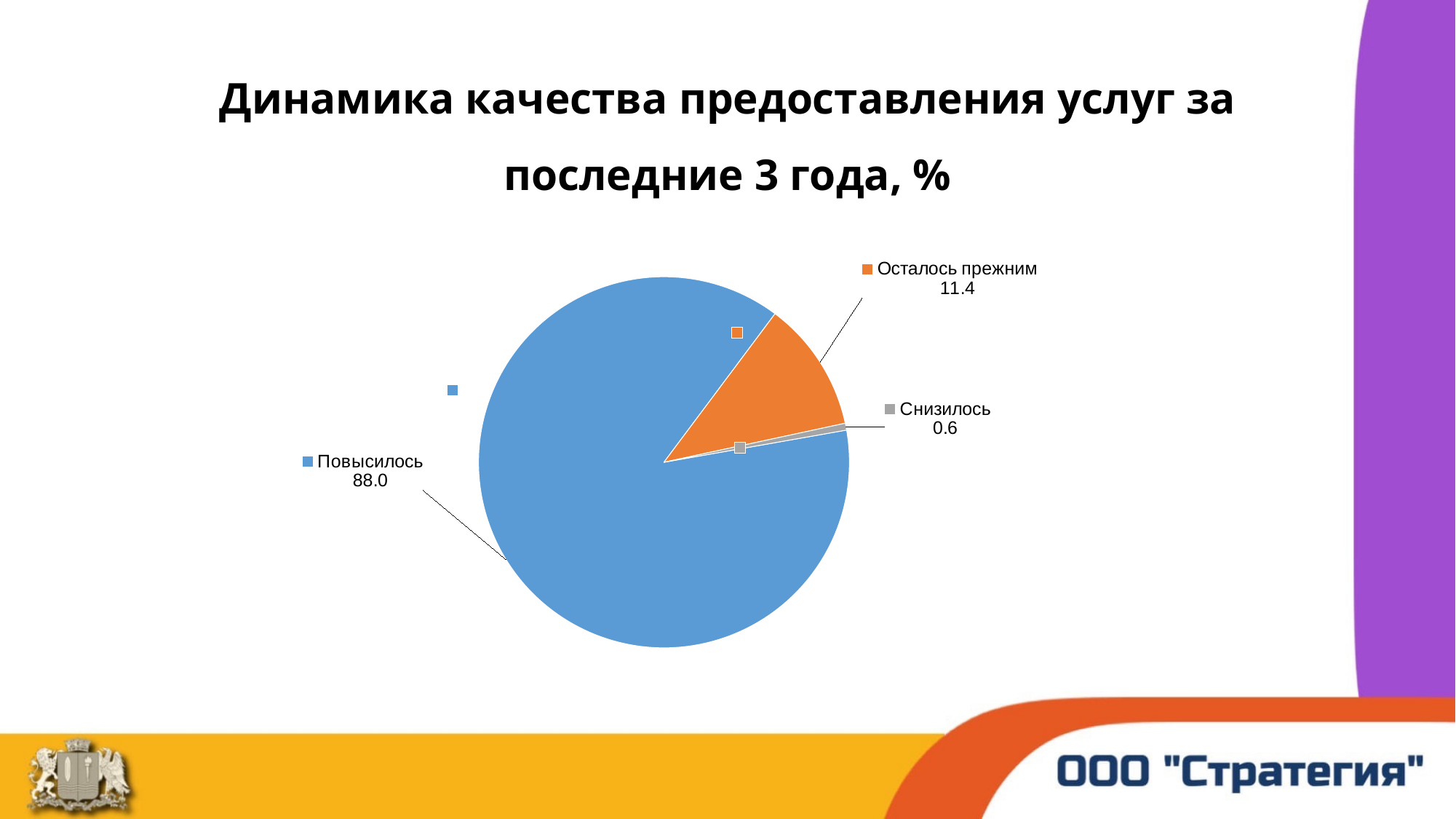
What is the value for Снизилось? 0.6 Which is larger, Осталось прежним or Снизилось? Осталось прежним What is the title of the chart? Динамика качества предоставления услуг за последние 3 года, % How many slices does the pie chart have? 3 What kind of chart is shown on the slide? pie chart What is the difference between the values for Повысилось and Осталось прежним? 76.6 What is the value for Осталось прежним? 11.4 Which category has the smallest slice? Снизилось Which category has the largest slice? Повысилось What colour is the slice for Осталось прежним? orange What is the difference between the values for Осталось прежним and Снизилось? 10.8 What is the value for Повысилось? 88.0